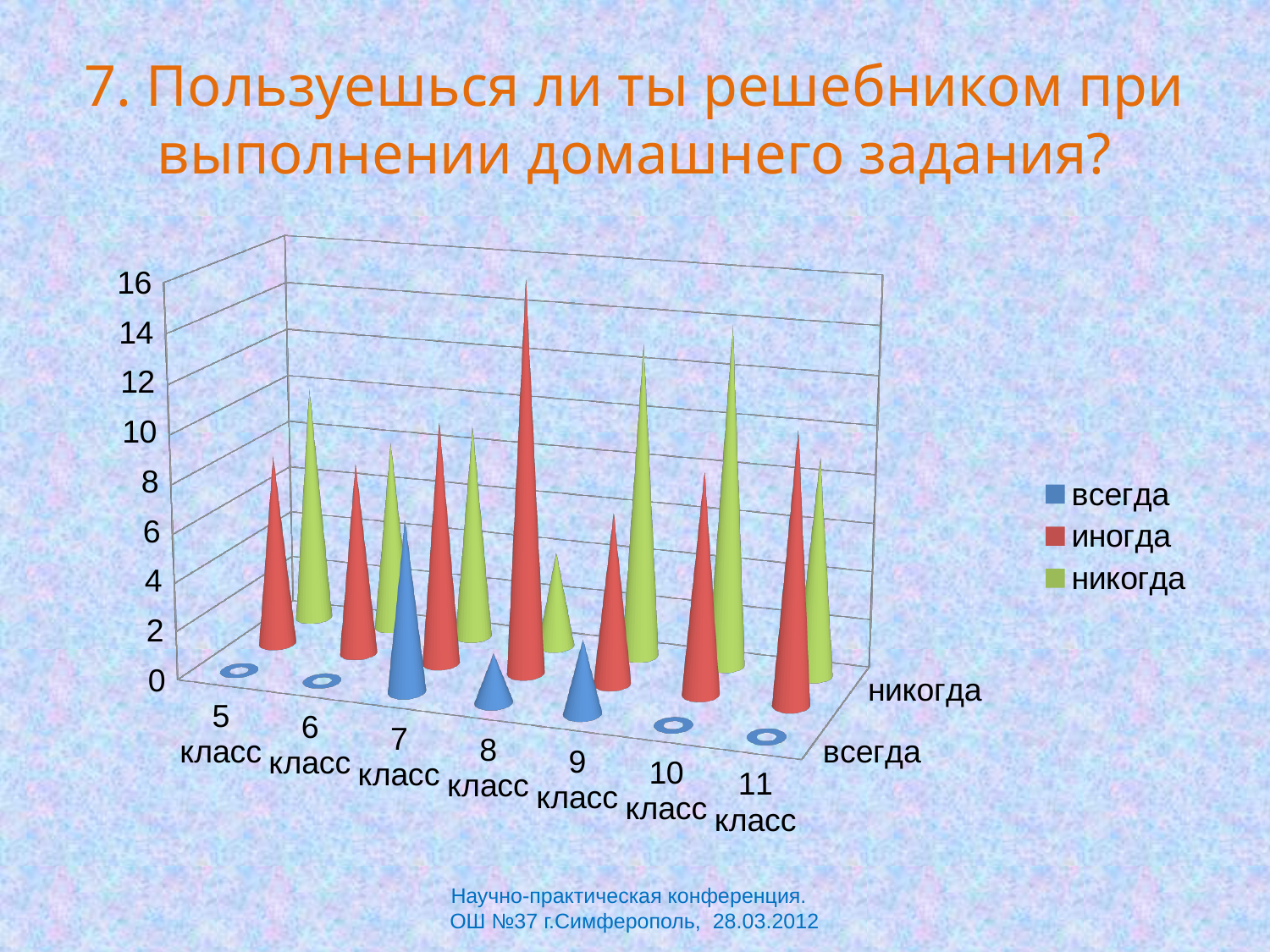
Is the value for "всегда" in 7 класс greater or less than 4? greater Which is larger: the value for "никогда" in 5 класс or in 6 класс? 5 класс Which colour represents the series "иногда" in the chart? red Which class has the highest value for the series "всегда"? 7 класс Which class has the lowest value for the series "никогда"? 8 класс What kind of chart is shown on the slide? bar chart Is the value for "иногда" in 8 класс greater or less than 10? greater Which class has the highest value for the series "иногда"? 8 класс Is the value for "всегда" in 8 класс greater or less than 4? less What are the three series named in the chart legend? всегда, иногда, никогда How many series does the chart legend list? 3 How many classes (categories) are shown along the x axis of the chart? 7